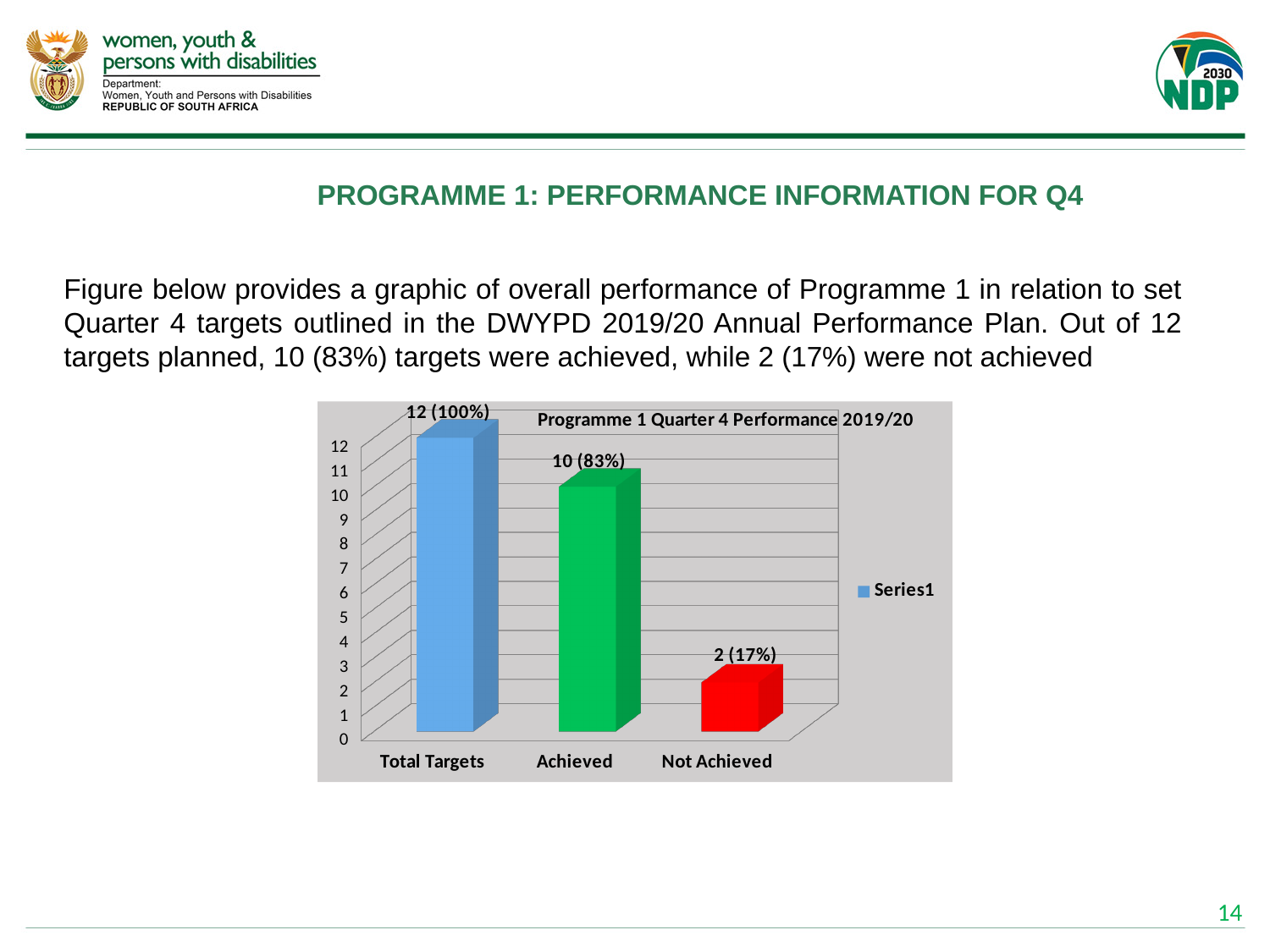
How many categories are shown on the x axis? 3 What kind of chart is shown? bar chart Is the value for Achieved greater or less than 6? greater What is the value shown for Not Achieved? 2 (17%) What is the title of the chart? Programme 1 Quarter 4 Performance 2019/20 What is the difference between the number of targets Achieved and Not Achieved? 8 What is the value shown for Achieved? 10 (83%) Which category has the highest value? Total Targets How many series does the legend list? 1 Which is larger, the value for Achieved or the value for Not Achieved? Achieved Which category has the lowest value? Not Achieved What is the value shown for Total Targets? 12 (100%)